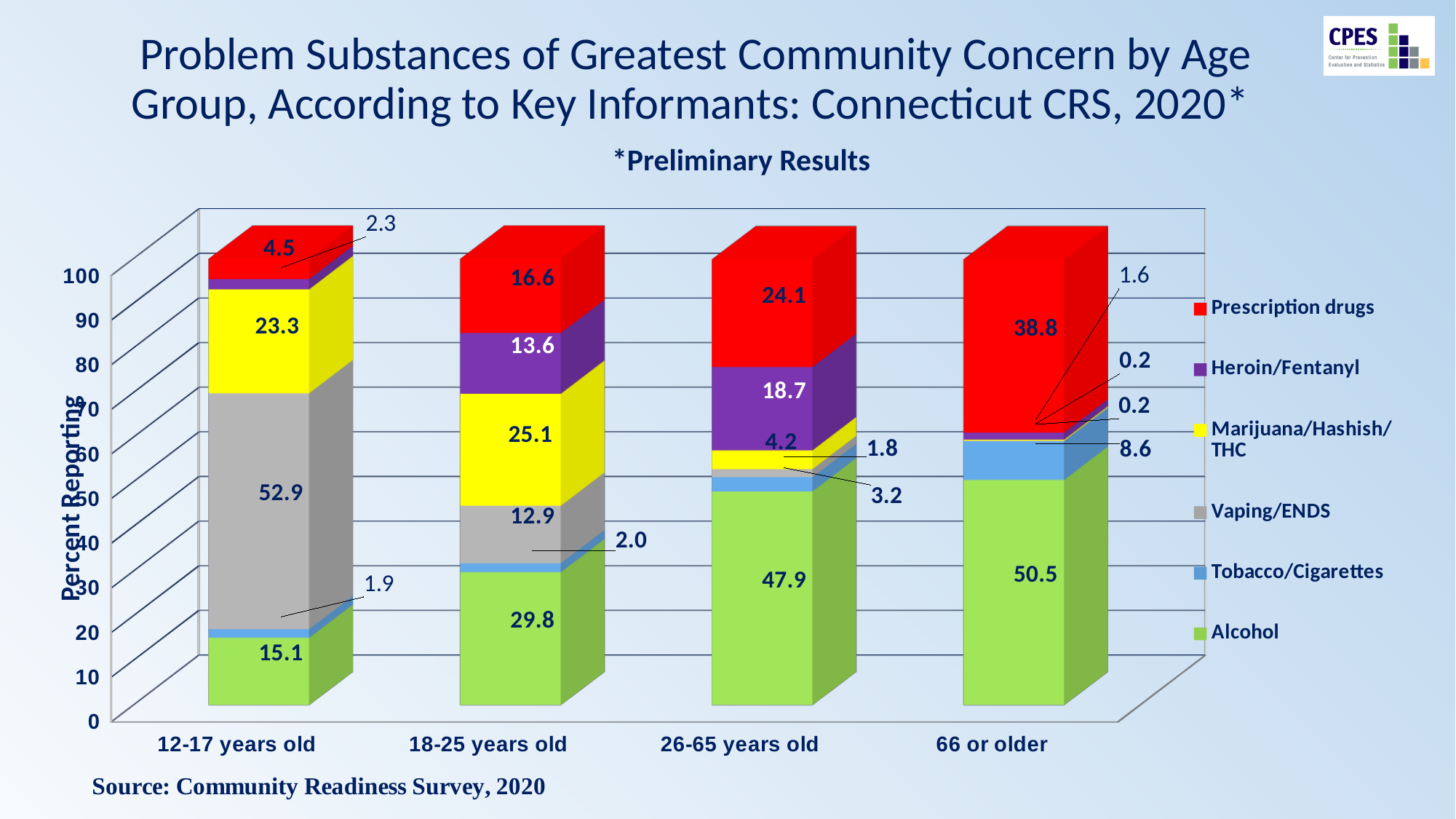
How many series does the legend list? 6 What is the value for Alcohol in the 18-25 years old age group? 29.8 What is the value for Prescription drugs in the 66 or older age group? 38.8 Which age group has the highest value for Alcohol? 66 or older How many age groups are shown on the x axis? 4 Which is larger: the Heroin/Fentanyl value for 18-25 years old or for 26-65 years old? 26-65 years old What percentage of key informants reported Vaping/ENDS as the problem substance of greatest concern for 12-17 years old? 52.9 What is the value for Heroin/Fentanyl in the 26-65 years old age group? 18.7 What is the difference between the Marijuana/Hashish/THC values for 18-25 years old and 12-17 years old? 1.8 Which age group has the lowest value for Prescription drugs? 12-17 years old Do the Alcohol values rise or fall as the age groups move from youngest to oldest along the x axis? Rise What kind of chart is shown on the slide? Stacked bar chart